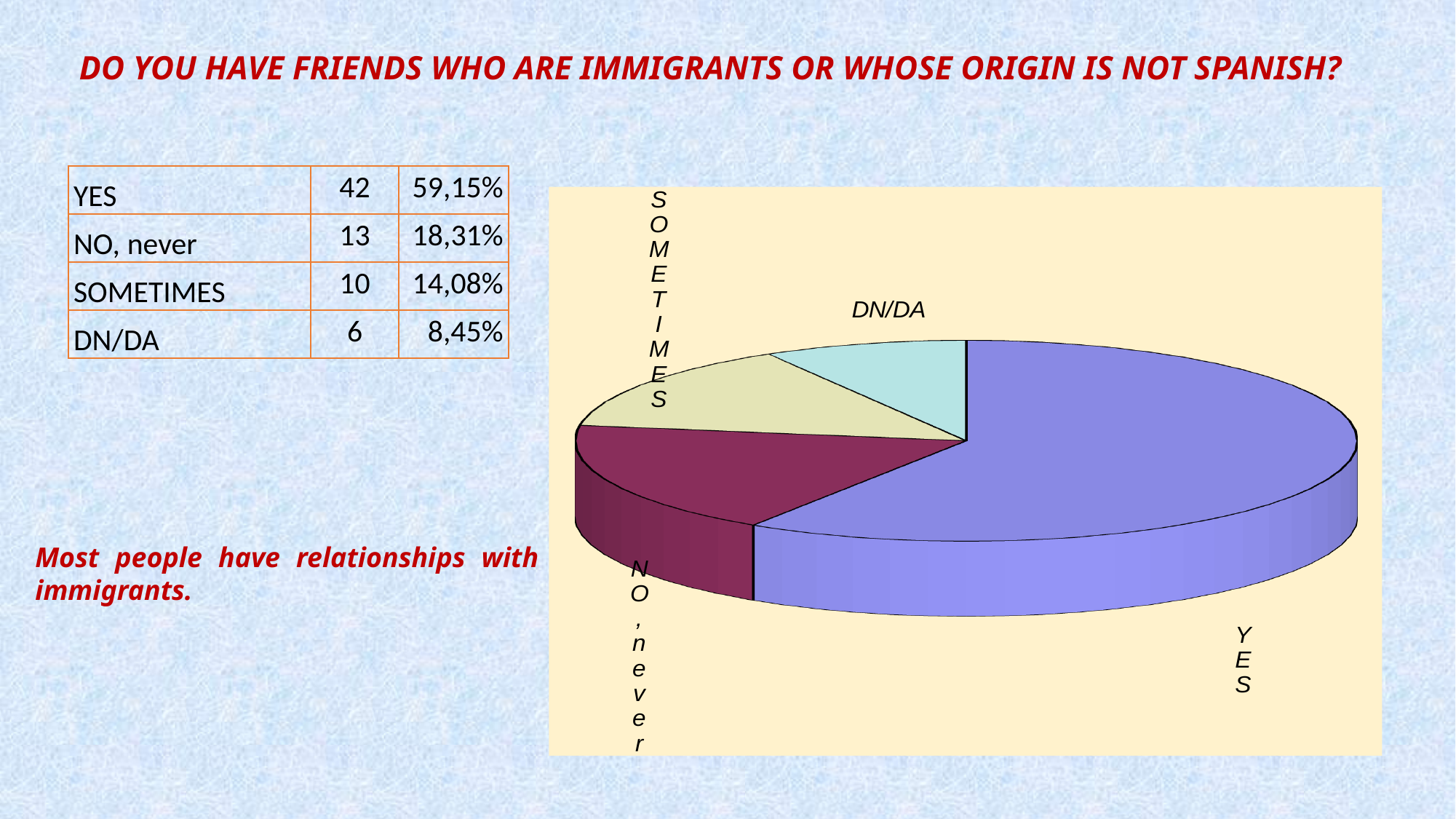
Is the slice for SOMETIMES larger or smaller than the slice for DN/DA? larger Which category has the smallest slice of the pie chart? DN/DA According to the table on the slide, what percentage share does the DN/DA slice represent? 8,45% Using the counts in the table, how many more respondents answered YES than NO, never? 29 According to the table on the slide, what percentage share does the YES slice represent? 59,15% According to the table on the slide, how many respondents answered SOMETIMES? 10 What colour is the YES slice of the pie chart? blue/purple Which category has the largest slice of the pie chart? YES What kind of chart is shown on the slide? pie chart According to the table on the slide, how many respondents answered NO, never? 13 How many slices does the pie chart have? 4 Is the slice for NO, never larger or smaller than the slice for YES? smaller